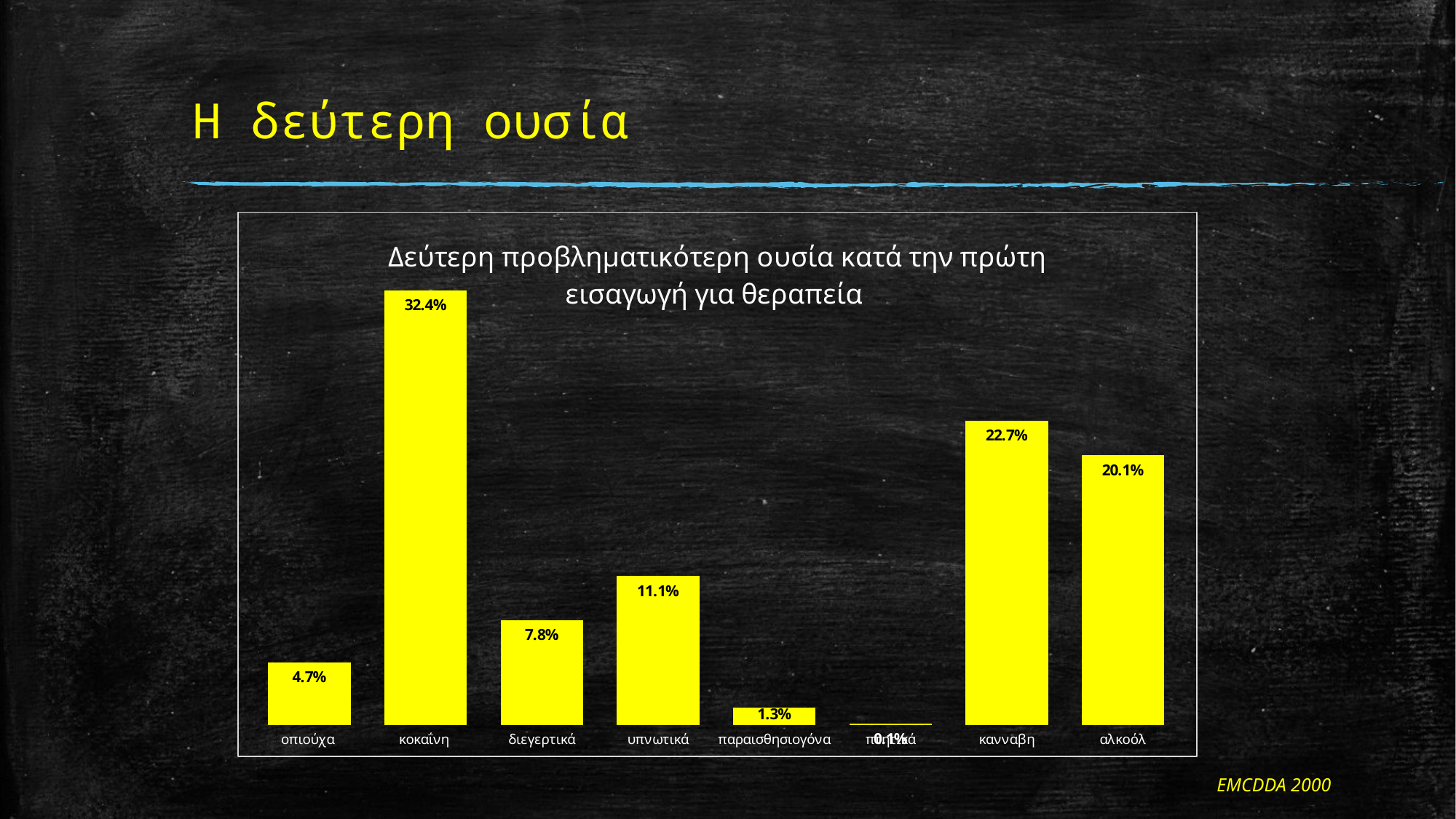
What is the difference between the values for κοκαΐνη and οπιούχα? 27.7% Which is larger, the value for κανναβη or the value for αλκοόλ? κανναβη What is the value for κοκαΐνη? 32.4% What is the difference between the values for κανναβη and αλκοόλ? 2.6% Which is larger, the value for διεγερτικά or the value for υπνωτικά? υπνωτικά What kind of chart is shown on the slide? bar chart How many categories are shown in the chart? 8 What is the value for υπνωτικά? 11.1% What source is cited at the bottom right of the slide? EMCDDA 2000 What is the value for παραισθησιογόνα? 1.3% Which category has the highest value? κοκαΐνη What is the value for αλκοόλ? 20.1%